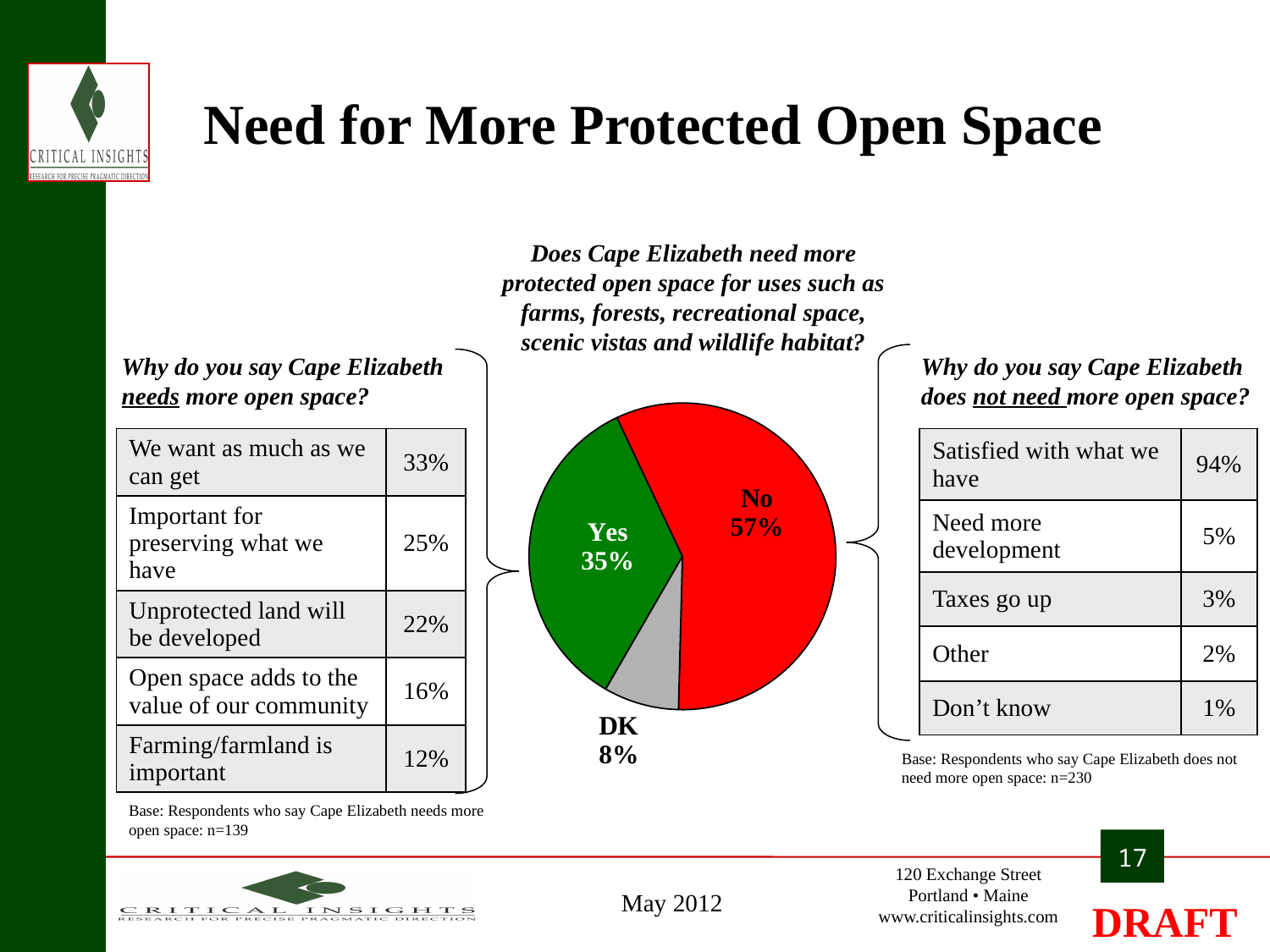
Which slice is larger in the pie chart, "Yes" or "DK"? Yes What colour is the "Yes" slice in the pie chart? green Which response has the smallest slice in the pie chart? DK What share of respondents answered "DK" in the pie chart? 8% Which response has the largest slice in the pie chart? No What kind of chart is shown on the slide? pie chart What is the difference in percentage points between the "No" and "Yes" slices of the pie chart? 22 How many slices does the pie chart have? 3 What is the combined share of the "Yes" and "DK" slices in the pie chart? 43% What colour is the "No" slice in the pie chart? red What share of respondents answered "Yes" in the pie chart? 35% What share of respondents answered "No" in the pie chart? 57%